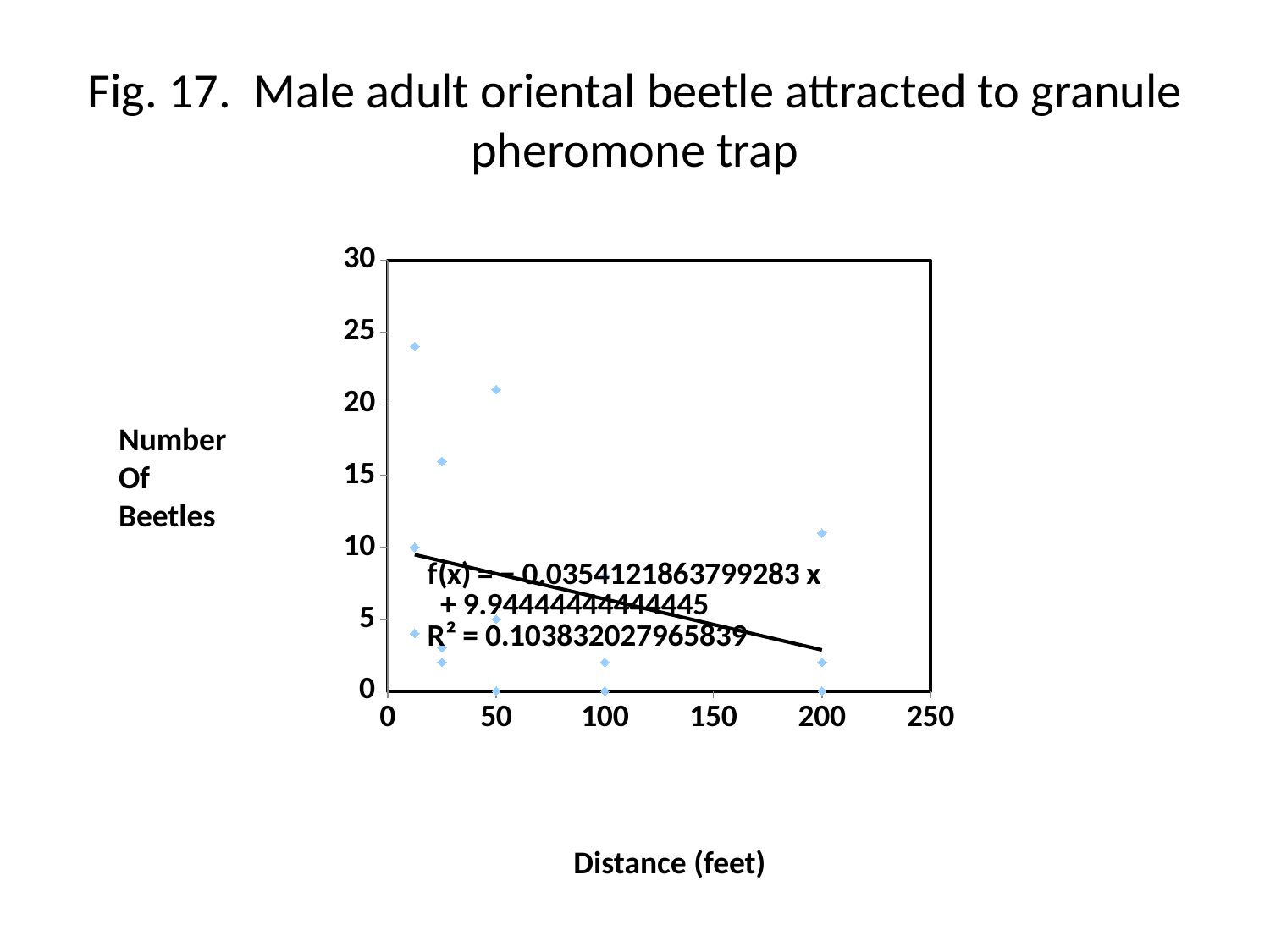
What is the label of the x axis? Distance (feet) What is the intercept of the fitted line f(x) printed on the chart? 9.94444444444445 What is the title of the chart on the slide? Fig. 17. Male adult oriental beetle attracted to granule pheromone trap Is the highest number of beetles recorded at a distance of 200 feet greater or less than 15? less Is the highest number of beetles recorded at a distance of 50 feet greater or less than 15? greater What is the slope of the fitted line f(x) printed on the chart? -0.0354121863799283 Does the fitted trendline rise or fall as distance increases? fall What is the maximum value shown on the y axis? 30 What R² value is printed on the chart? 0.103832027965839 What kind of chart is shown on the slide? scatter plot Is the highest number of beetles recorded at a distance of about 12 feet greater or less than 20? greater